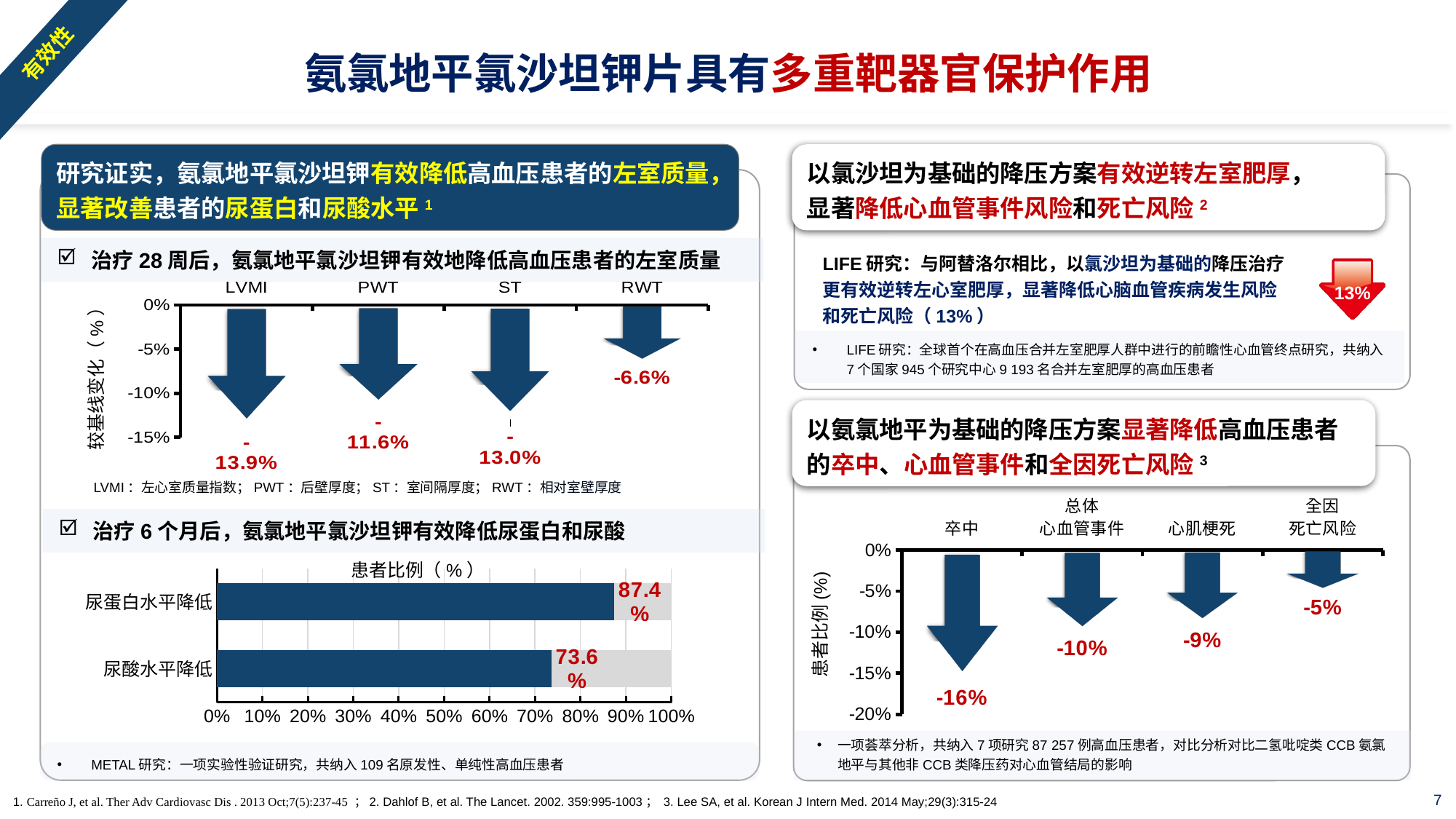
In the top-left chart (较基线变化), how many categories are plotted? 4 In the top-left chart (较基线变化), what is the value for LVMI? -13.9% In the top-left chart (较基线变化), which category shows the largest reduction from baseline? LVMI In the bottom-right chart (患者比例 (%)), what is the value for 卒中? -16% What kind of chart is the bottom-left chart (患者比例)? Bar chart In the top-left chart (较基线变化), which category shows the smallest reduction from baseline? RWT In the bottom-right chart (患者比例 (%)), what is the difference between the 总体心血管事件 and 心肌梗死 values? 1% In the top-left chart (较基线变化), what is the value for RWT? -6.6% In the bottom-left chart (患者比例), what percentage of patients had 尿蛋白水平降低? 87.4% In the bottom-left chart (患者比例), what percentage of patients had 尿酸水平降低? 73.6% In the bottom-right chart (患者比例 (%)), which category has the smallest reduction? 全因死亡风险 In the bottom-left chart (患者比例), what is the difference between the 尿蛋白水平降低 and 尿酸水平降低 values? 13.8%